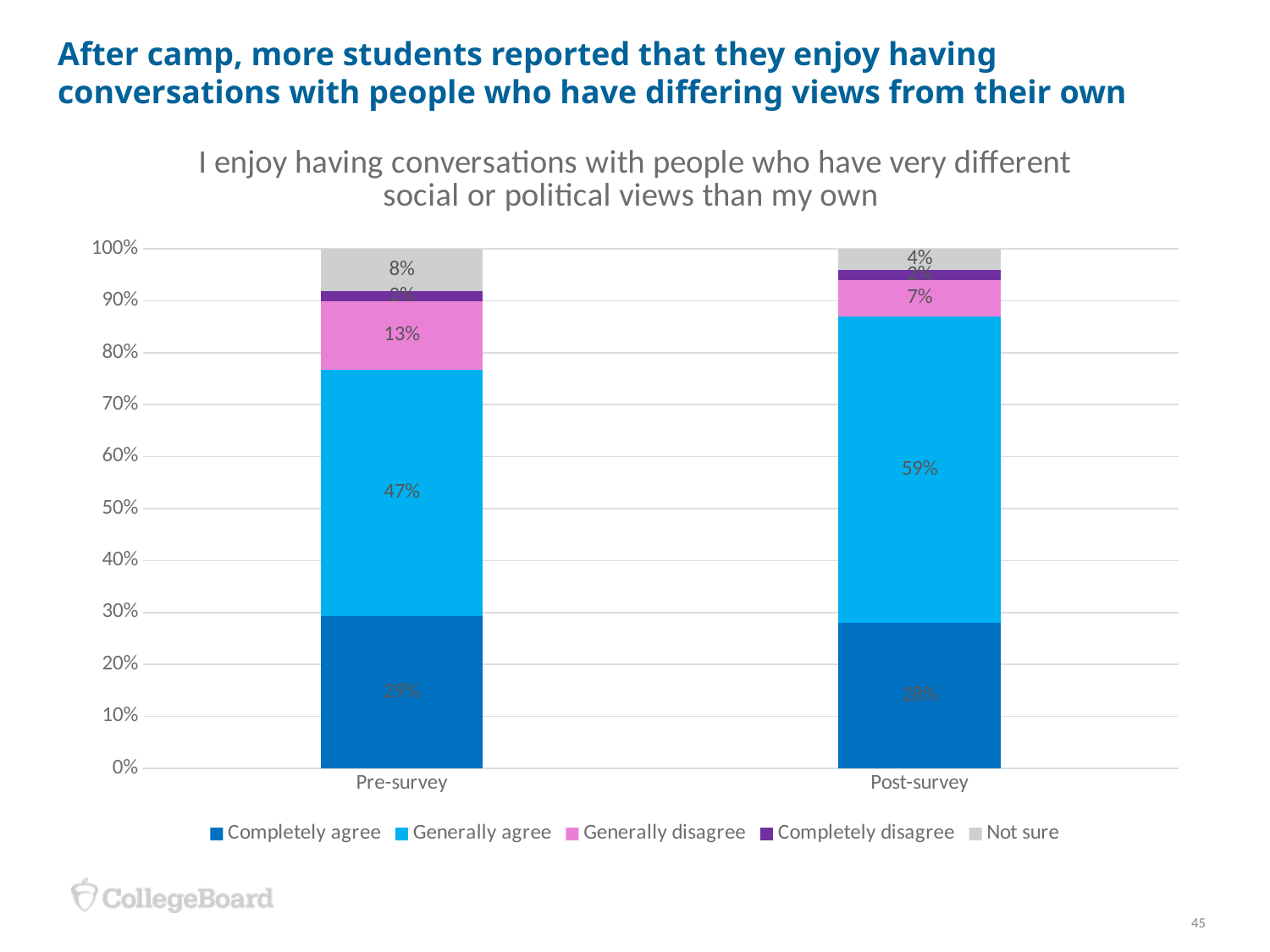
What percentage of students selected 'Generally agree' in the Pre-survey? 47% What is the title of the chart? I enjoy having conversations with people who have very different social or political views than my own How many series does the chart's legend list? 5 What is the 'Not sure' value for the Pre-survey? 8% How many categories are shown on the x axis of the chart? 2 What is the 'Generally disagree' value for the Post-survey? 7% By how many percentage points did 'Generally agree' increase from the Pre-survey to the Post-survey? 12 percentage points What kind of chart is shown on the slide? Stacked bar chart Which survey has the larger 'Generally disagree' share, Pre-survey or Post-survey? Pre-survey What is the 'Completely agree' value for the Pre-survey? 29% What is the difference between the 'Generally disagree' values for the Pre-survey and the Post-survey? 6 percentage points What percentage of students selected 'Generally agree' in the Post-survey? 59%